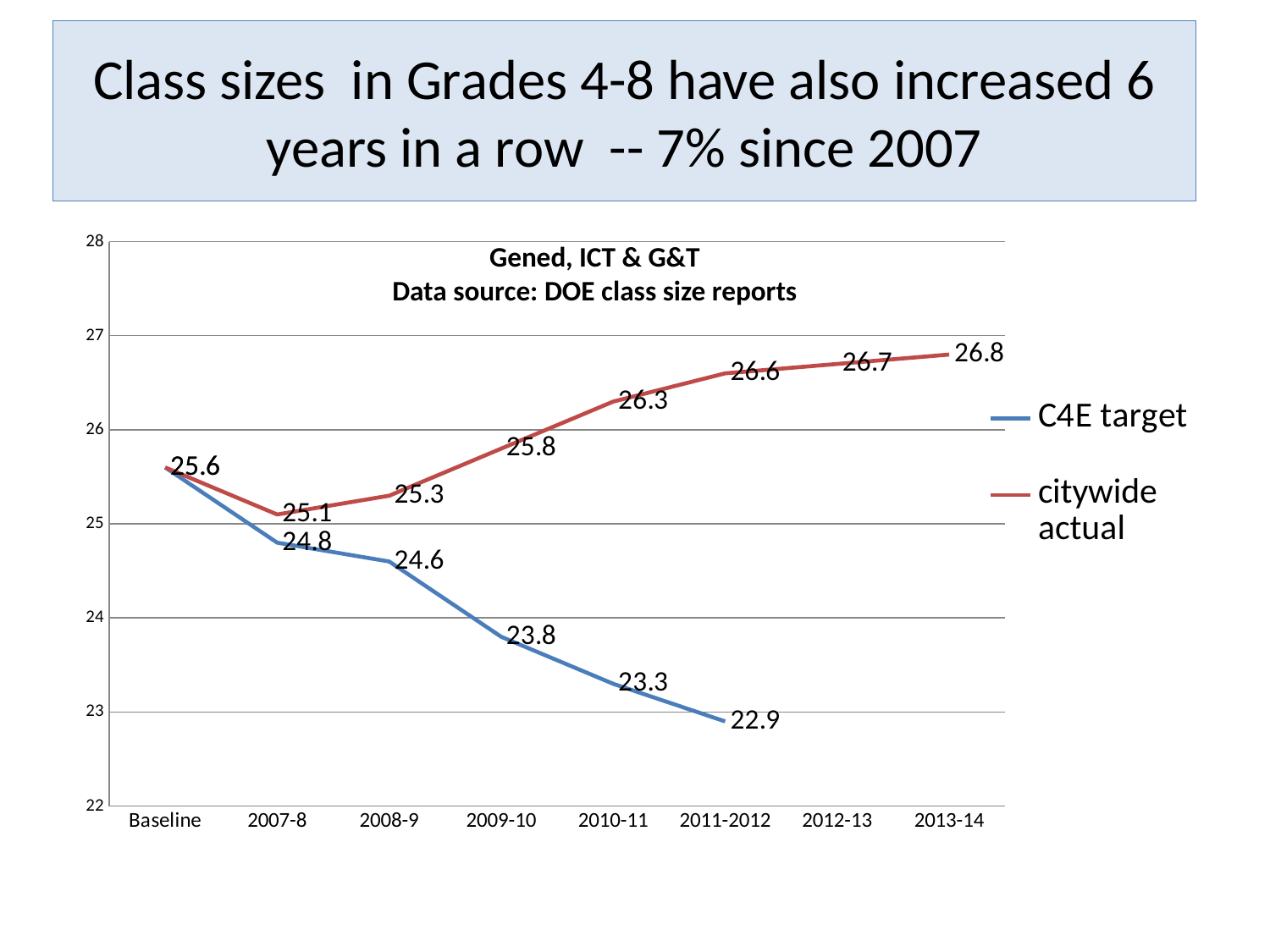
What is the citywide actual value for 2009-10? 25.8 In which year is the C4E target value lowest? 2011-2012 Does the C4E target line rise or fall from Baseline to 2011-2012? fall What is the difference between the citywide actual and the C4E target values in 2010-11? 3.0 Which is larger in 2007-8, the citywide actual value or the C4E target value? citywide actual How many categories are shown on the x axis? 8 What is the C4E target value for 2008-9? 24.6 In which year is the citywide actual value highest? 2013-14 What is the C4E target value for 2011-2012? 22.9 How many series does the legend list? 2 What is the citywide actual value for 2013-14? 26.8 What kind of chart is shown on the slide? line chart